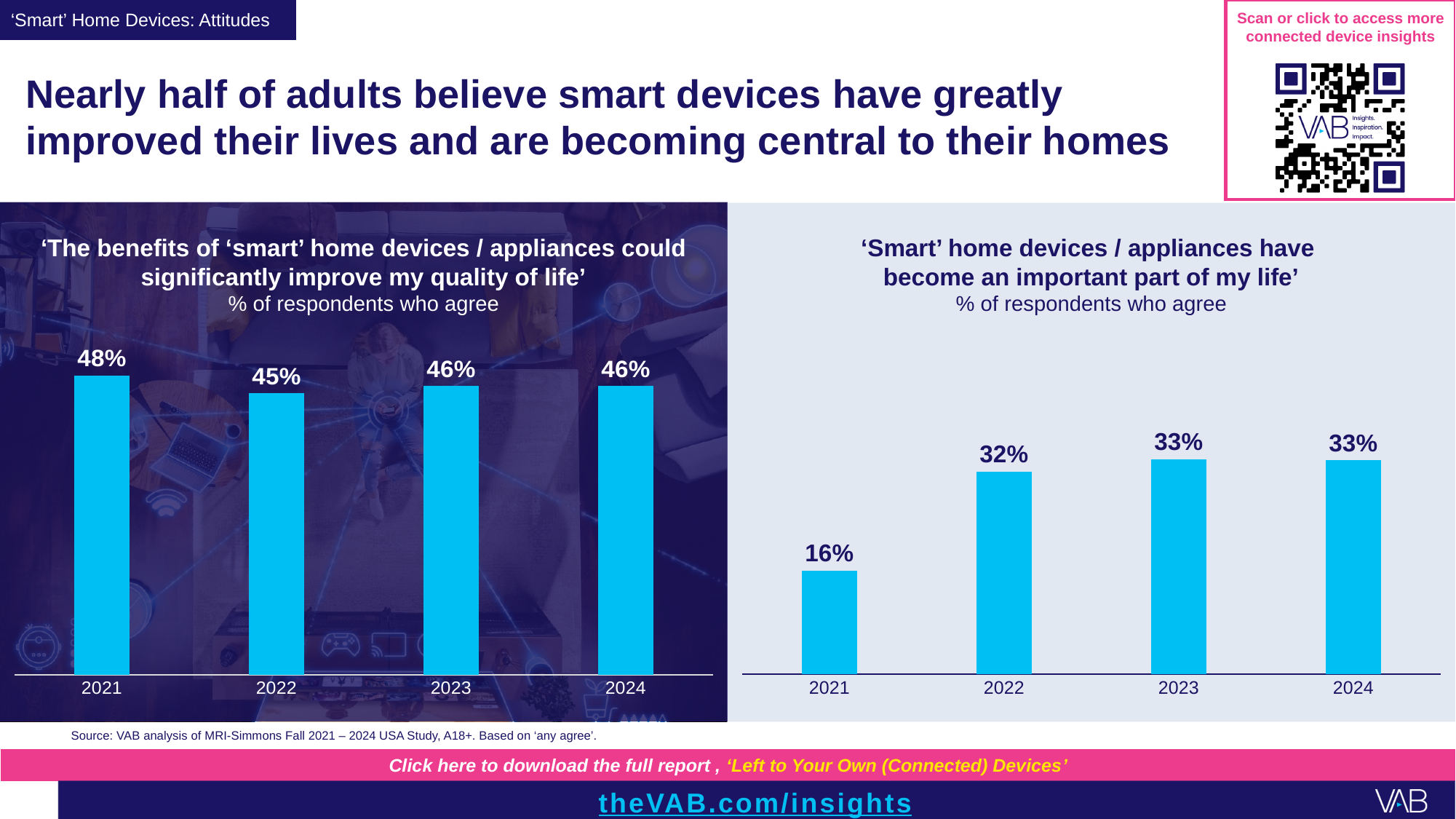
How many years are shown on the x axis of the right chart ('Smart home devices / appliances have become an important part of my life')? 4 What type of chart is the left chart ('The benefits of smart home devices could significantly improve my quality of life')? bar chart In the left chart ('The benefits of smart home devices could significantly improve my quality of life'), what percentage of respondents agreed in 2022? 45% In the left chart ('The benefits of smart home devices could significantly improve my quality of life'), what percentage of respondents agreed in 2021? 48% In the left chart ('The benefits of smart home devices could significantly improve my quality of life'), which year has the lowest value? 2022 In the left chart ('The benefits of smart home devices could significantly improve my quality of life'), what is the difference between the 2021 value and the 2022 value? 3% In the right chart ('Smart home devices / appliances have become an important part of my life'), what is the difference between the 2022 value and the 2021 value? 16% In the right chart ('Smart home devices / appliances have become an important part of my life'), is the value for 2022 larger or smaller than the value for 2021? larger In the right chart ('Smart home devices / appliances have become an important part of my life'), what percentage of respondents agreed in 2022? 32% In the left chart ('The benefits of smart home devices could significantly improve my quality of life'), which year has the highest value? 2021 In the right chart ('Smart home devices / appliances have become an important part of my life'), what percentage of respondents agreed in 2021? 16% In the right chart ('Smart home devices / appliances have become an important part of my life'), which year has the lowest value? 2021